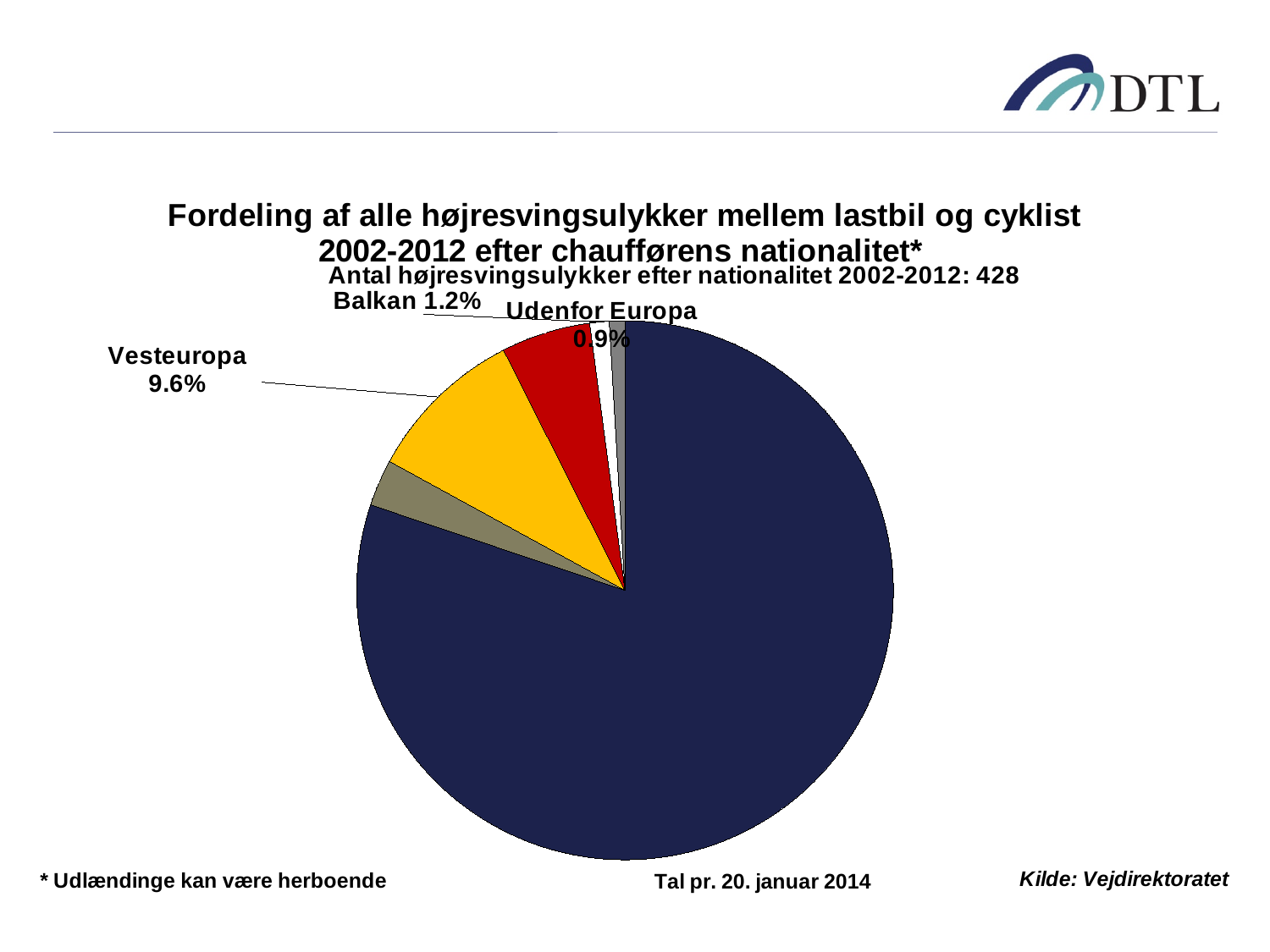
How many percentage points larger is the Balkan share than the Udenfor Europa share? 0.3 percentage points Which has the larger share, Balkan or Udenfor Europa? Balkan Which has the larger share, Vesteuropa or Balkan? Vesteuropa What kind of chart is shown on the slide? Pie chart What share of the pie does Udenfor Europa account for? 0.9% What share of the pie does Vesteuropa account for? 9.6% According to the chart title, what is the total number of right-turn accidents by nationality for 2002-2012? 428 How many percentage points larger is the Vesteuropa share than the Balkan share? 8.4 percentage points How many slices does the pie chart have? 6 Of the labelled slices, which has the largest share? Vesteuropa Of the labelled slices, which has the smallest share? Udenfor Europa What share of the pie does Balkan account for? 1.2%